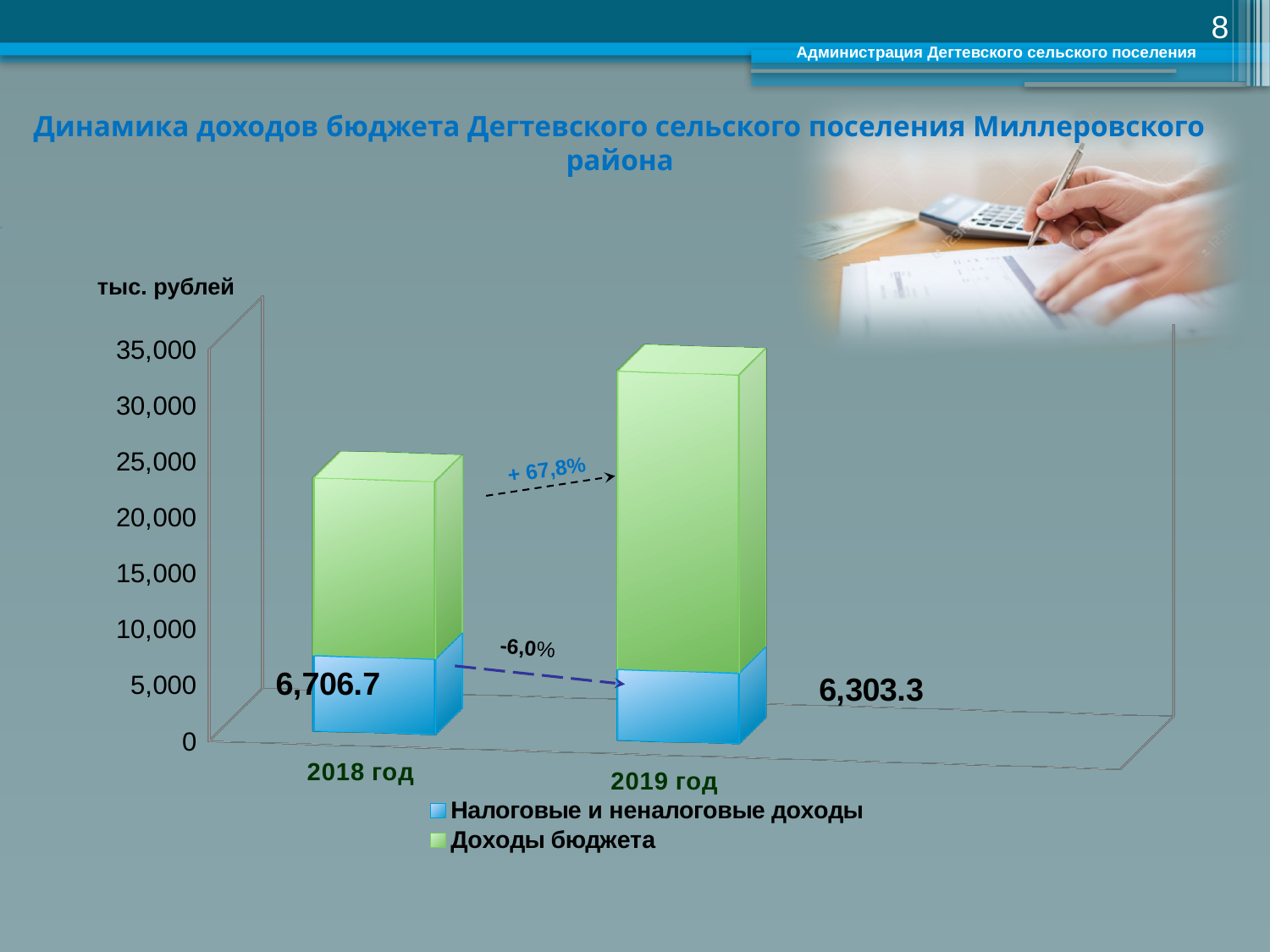
Is the total stacked bar for 2018 год greater or less than 20,000? greater How many years (categories) are shown on the x axis? 2 Which year has the larger value for Налоговые и неналоговые доходы, 2018 год or 2019 год? 2018 год What kind of chart is shown on the slide? Stacked bar chart What is the value of Налоговые и неналоговые доходы for 2018 год? 6,706.7 Is the total stacked bar for 2019 год greater or less than 30,000? greater What is the difference between the Налоговые и неналоговые доходы values for 2018 год and 2019 год? 403.4 How many series does the legend list? 2 Does the value of Налоговые и неналоговые доходы rise or fall from 2018 год to 2019 год? Fall Which year has the taller total stacked bar? 2019 год What is the value of Налоговые и неналоговые доходы for 2019 год? 6,303.3 What percentage change is annotated between the Доходы бюджета bars for 2018 год and 2019 год? + 67,8%